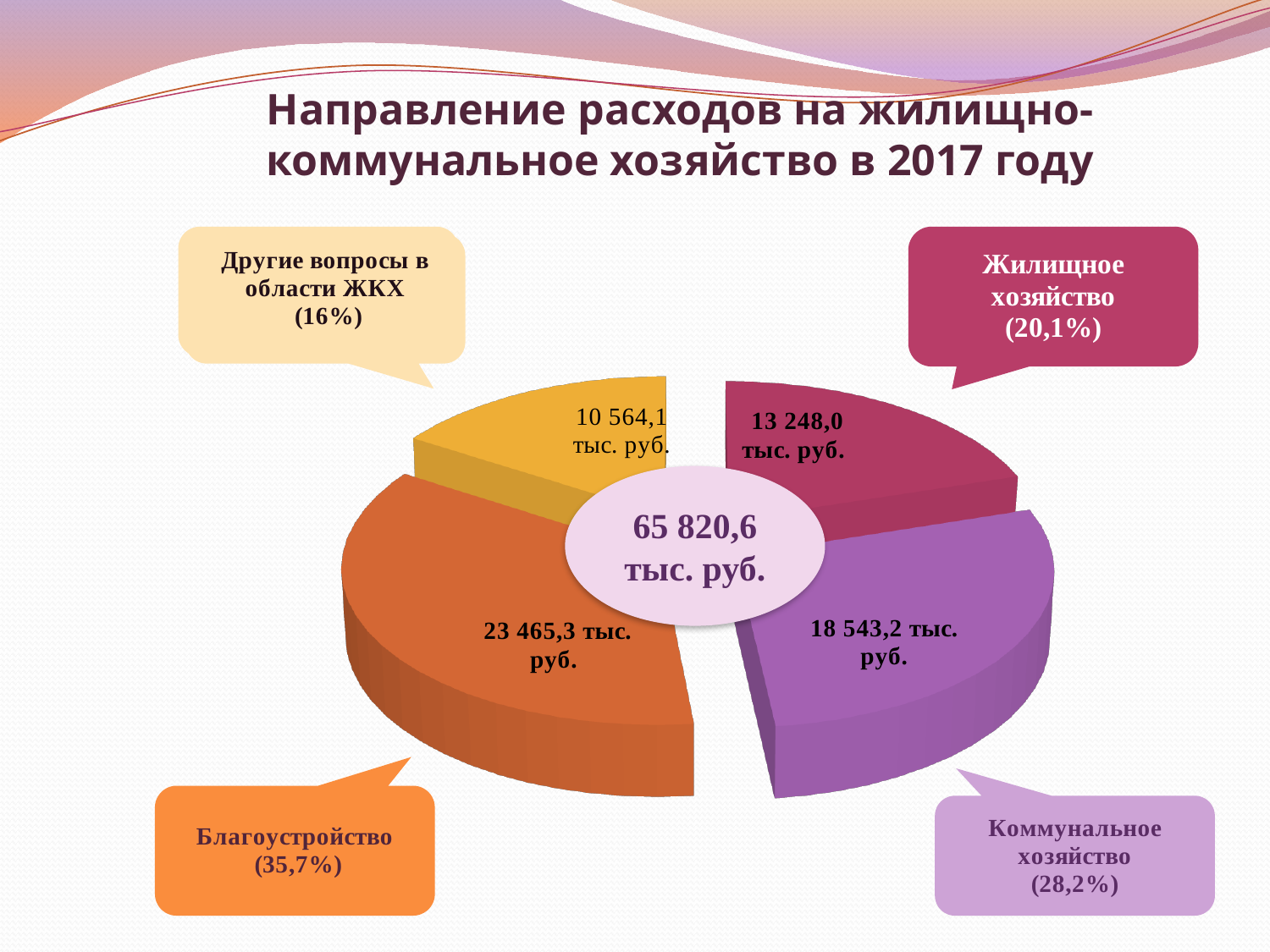
Какая доля расходов приходится на «Другие вопросы в области ЖКХ»? 16% Какая сумма расходов указана для сектора «Благоустройство»? 23 465,3 тыс. руб. Какая сумма расходов указана для сектора «Жилищное хозяйство»? 13 248,0 тыс. руб. Какой тип диаграммы показан на слайде? круговая диаграмма Сколько секторов (категорий) на круговой диаграмме? 4 Какая сумма расходов указана для сектора «Коммунальное хозяйство»? 18 543,2 тыс. руб. Какая общая сумма расходов указана в центре диаграммы? 65 820,6 тыс. руб. Что больше: расходы на «Жилищное хозяйство» или на «Коммунальное хозяйство»? Коммунальное хозяйство Какая доля расходов приходится на «Коммунальное хозяйство»? 28,2% Какое направление расходов имеет наибольшую долю? Благоустройство Какая сумма расходов указана для сектора «Другие вопросы в области ЖКХ»? 10 564,1 тыс. руб. Какое направление расходов имеет наименьшую долю? Другие вопросы в области ЖКХ